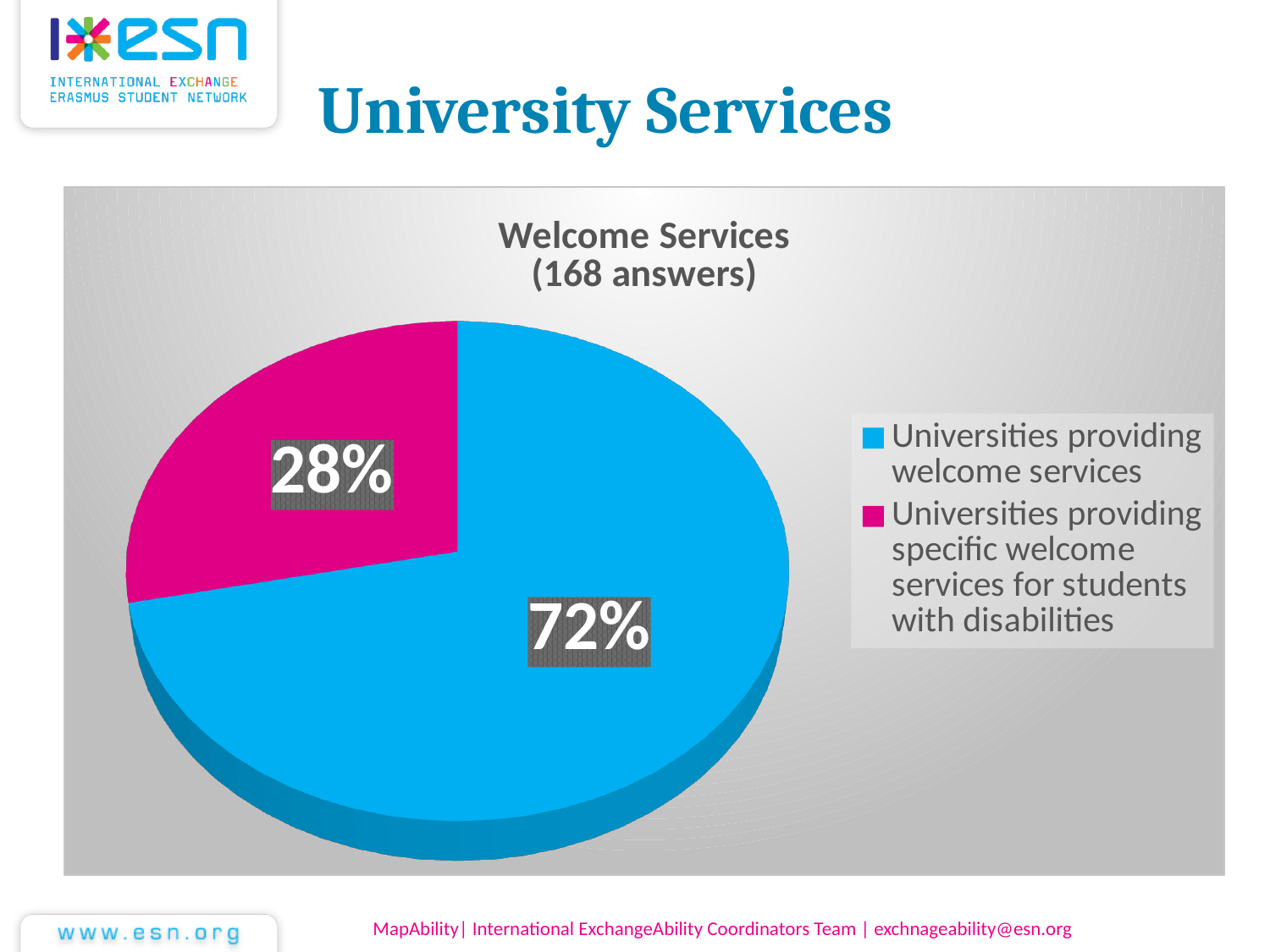
What kind of chart is shown on the slide? Pie chart Which is larger: the slice for universities providing welcome services or the slice for universities providing specific welcome services for students with disabilities? Universities providing welcome services What share of the pie is labelled for universities providing welcome services? 72% Which category has the largest slice of the pie? Universities providing welcome services What colour is the slice for universities providing specific welcome services for students with disabilities? Magenta (pink) What share of the pie is labelled for universities providing specific welcome services for students with disabilities? 28% What is the title of the chart? Welcome Services (168 answers) How many answers does the chart title say the data is based on? 168 What is the difference in percentage points between the two slices? 44 Which category has the smallest slice of the pie? Universities providing specific welcome services for students with disabilities How many entries does the legend list? 2 How many slices does the pie chart have? 2